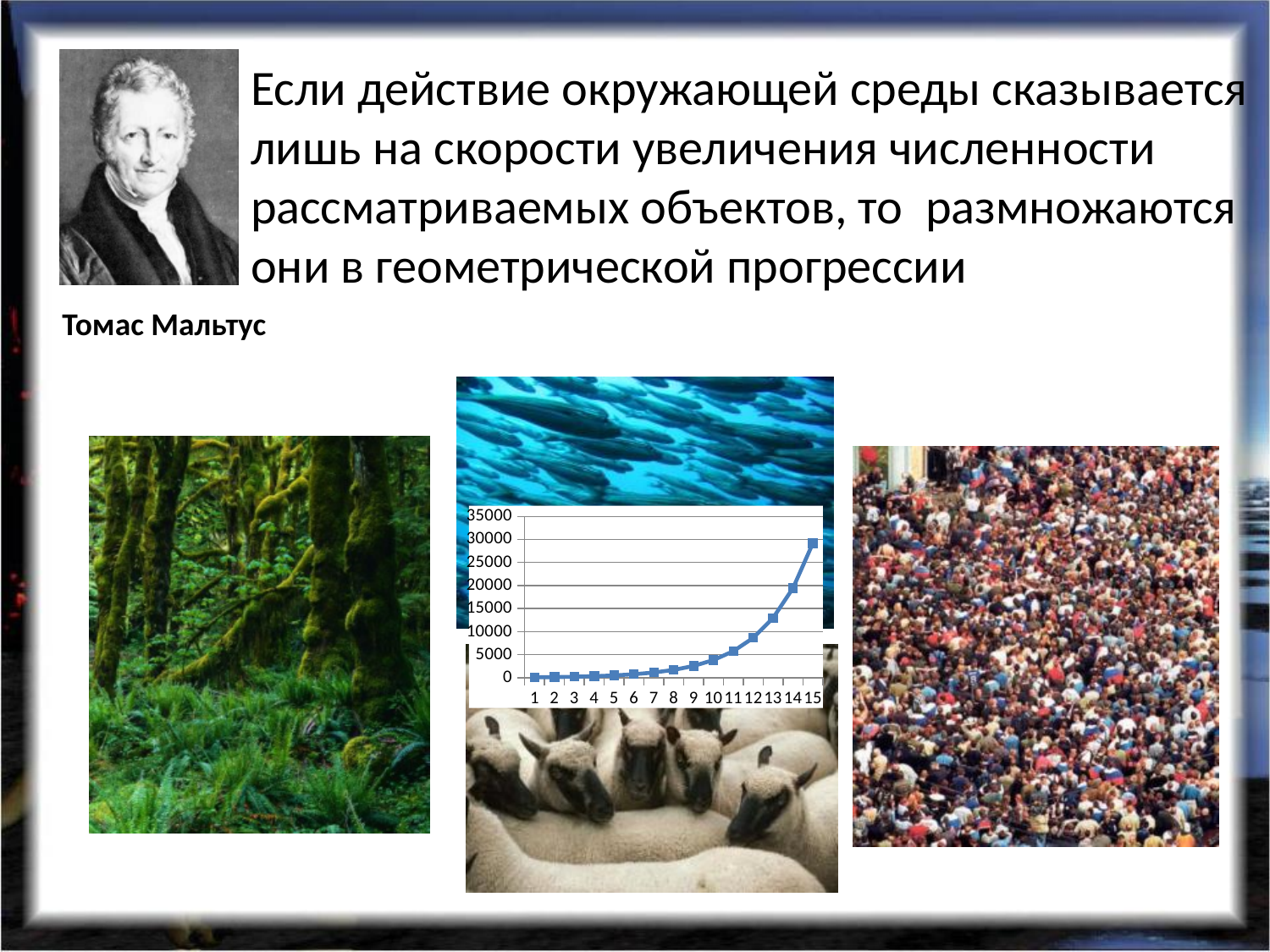
Which has the larger value, point 14 or point 15? 15 Is the value at point 12 greater or less than 10000? less How many points are plotted along the x axis of the chart? 15 Is the value at point 15 greater or less than 25000? greater Is the value at point 13 greater or less than 10000? greater What kind of chart is shown on the slide? line chart At which x-axis point is the plotted value highest? 15 What is the highest tick value shown on the y axis of the chart? 35000 Which has the larger value, point 5 or point 10? 10 At which x-axis point is the plotted value lowest? 1 Do the values in the chart rise or fall as the x axis goes from 1 to 15? rise